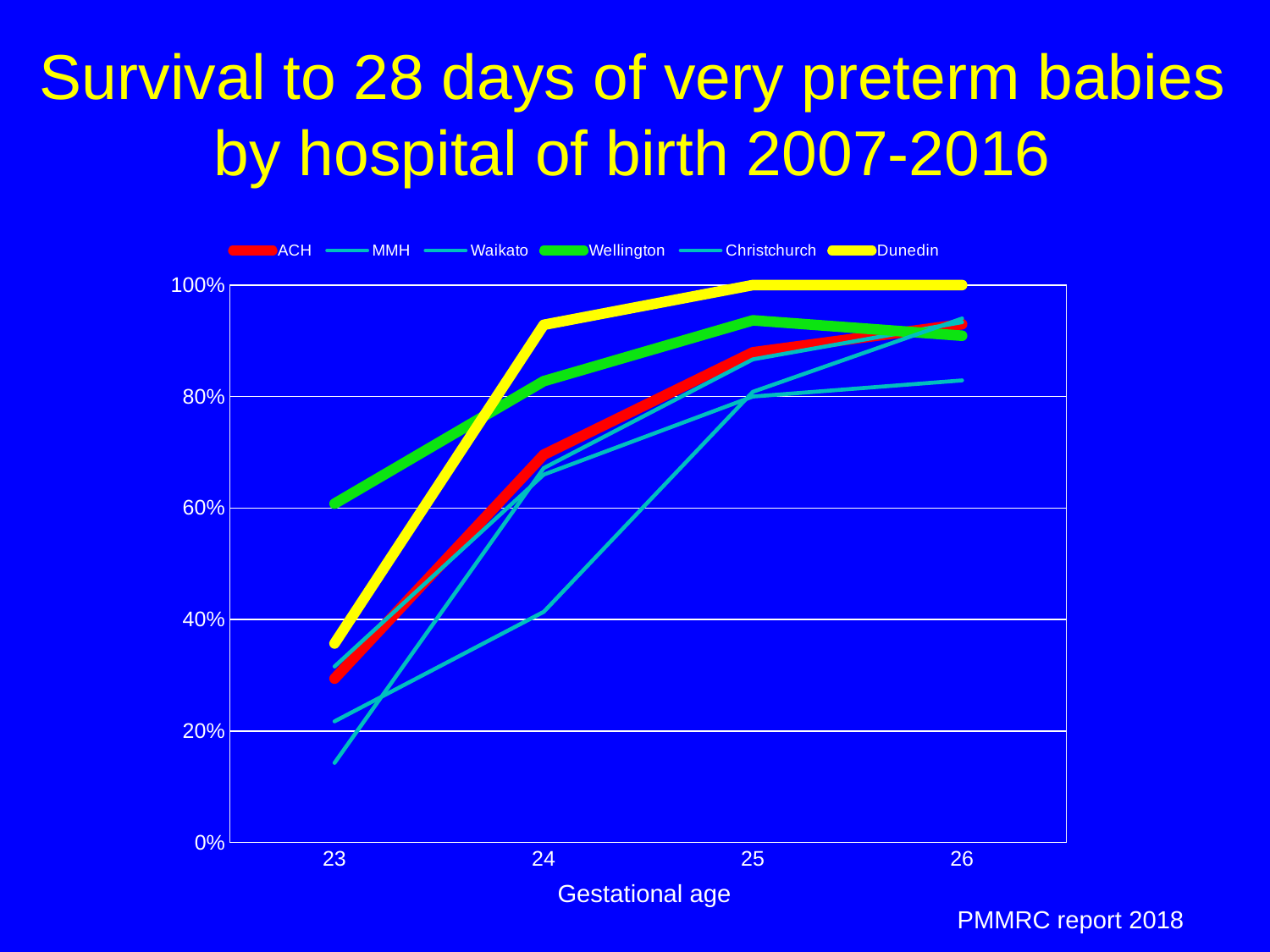
Is the survival value for ACH at gestational age 24 greater or less than 80%? less Is the survival value for Wellington at gestational age 24 greater or less than 80%? greater Is the survival value for Dunedin at gestational age 23 greater or less than 40%? less What kind of chart is shown on the slide? line chart Which hospital has the highest survival at gestational age 25? Dunedin Which hospital has the highest survival at gestational age 23? Wellington At gestational age 23, which is larger: the survival for Wellington or for Dunedin? Wellington How many series does the legend list? 6 What is the label of the x axis? Gestational age Which hospital has the highest survival at gestational age 24? Dunedin How many gestational age categories are shown on the x axis? 4 Does the survival for Dunedin rise or fall as gestational age increases from 23 to 25? rise